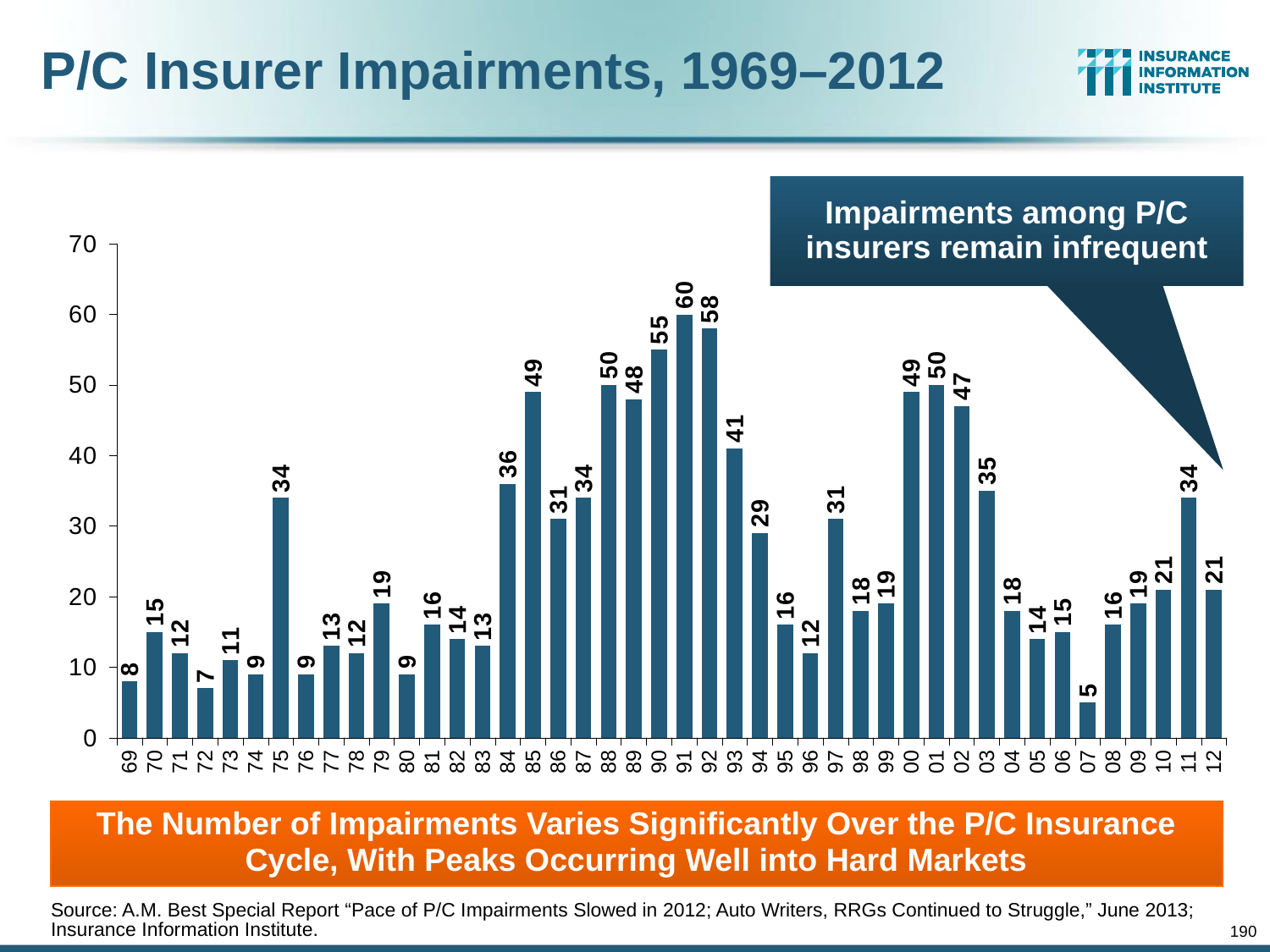
What is the number of impairments shown for the year labeled '12'? 21 Which year had more impairments, '85' or '02'? 85 What value is shown for the year labeled '07'? 5 Do the values rise or fall from '84' to '91'? Neither consistently; values rise overall from 36 to 60 but dip at '86 and '87 What is the number of P/C insurer impairments shown for 1991 (label '91')? 60 What is the difference between the impairments in '11' and '12'? 13 How many years (bars) are plotted on the chart? 44 What is the difference between the impairments in '91' and '92'? 2 Which year has the lowest number of impairments? 07 Which year had more impairments, '75' or '84'? 84 What type of chart is used on this slide? Bar chart Which year has the highest number of impairments? 91